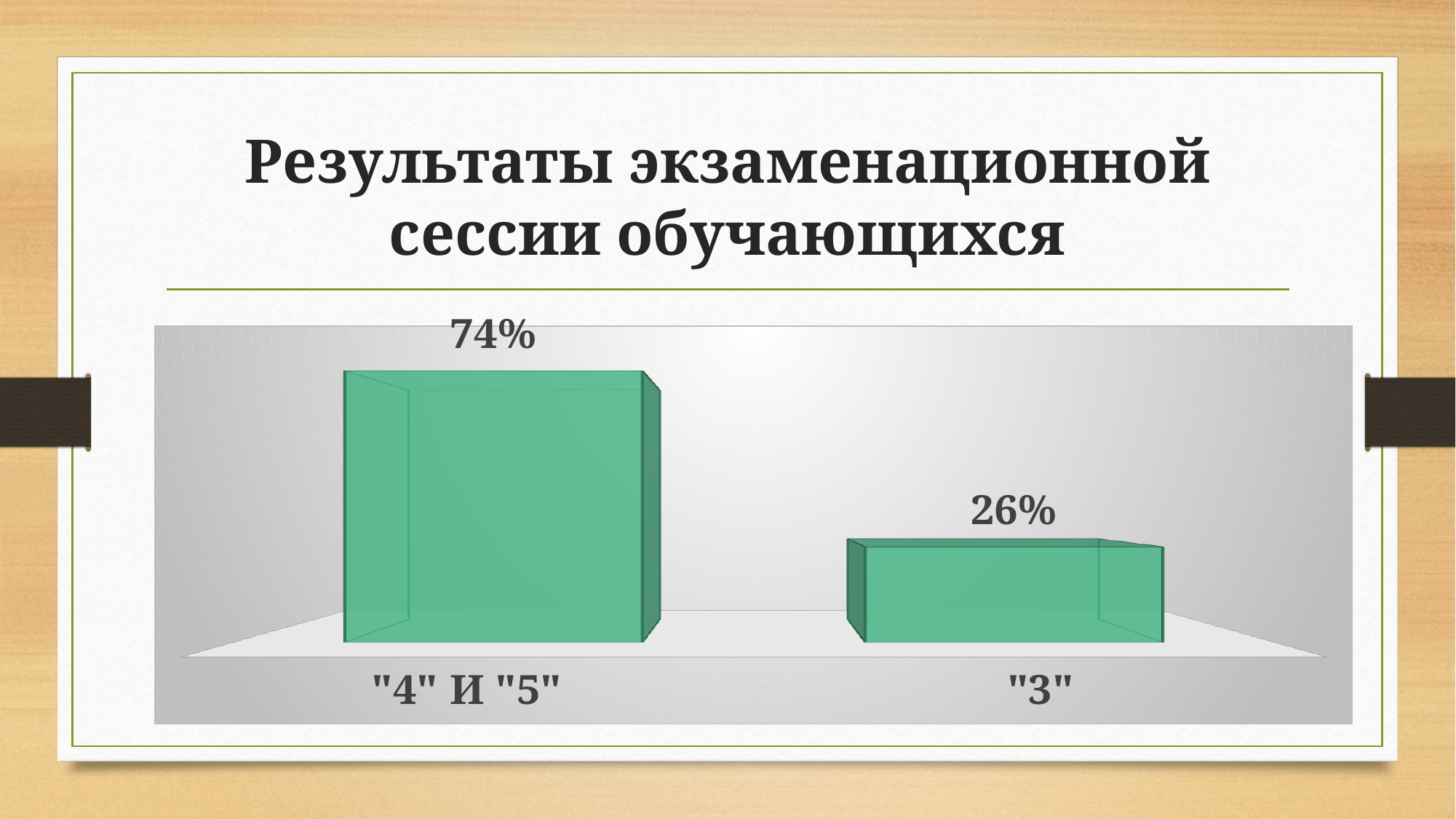
What is the value for "3"? 26% What is the title of the slide? Результаты экзаменационной сессии обучающихся Which category has the highest value? "4" и "5" What kind of chart is shown on the slide? Bar chart Which category has the lowest value? "3" What is the difference between the values for "4" и "5" and "3"? 48% Which is larger, the value for "4" и "5" or the value for "3"? "4" и "5" What is the total of the two values shown in the chart? 100% What colour are the bars in the chart? Green What is the value for "4" и "5"? 74% How many categories are shown in the chart? 2